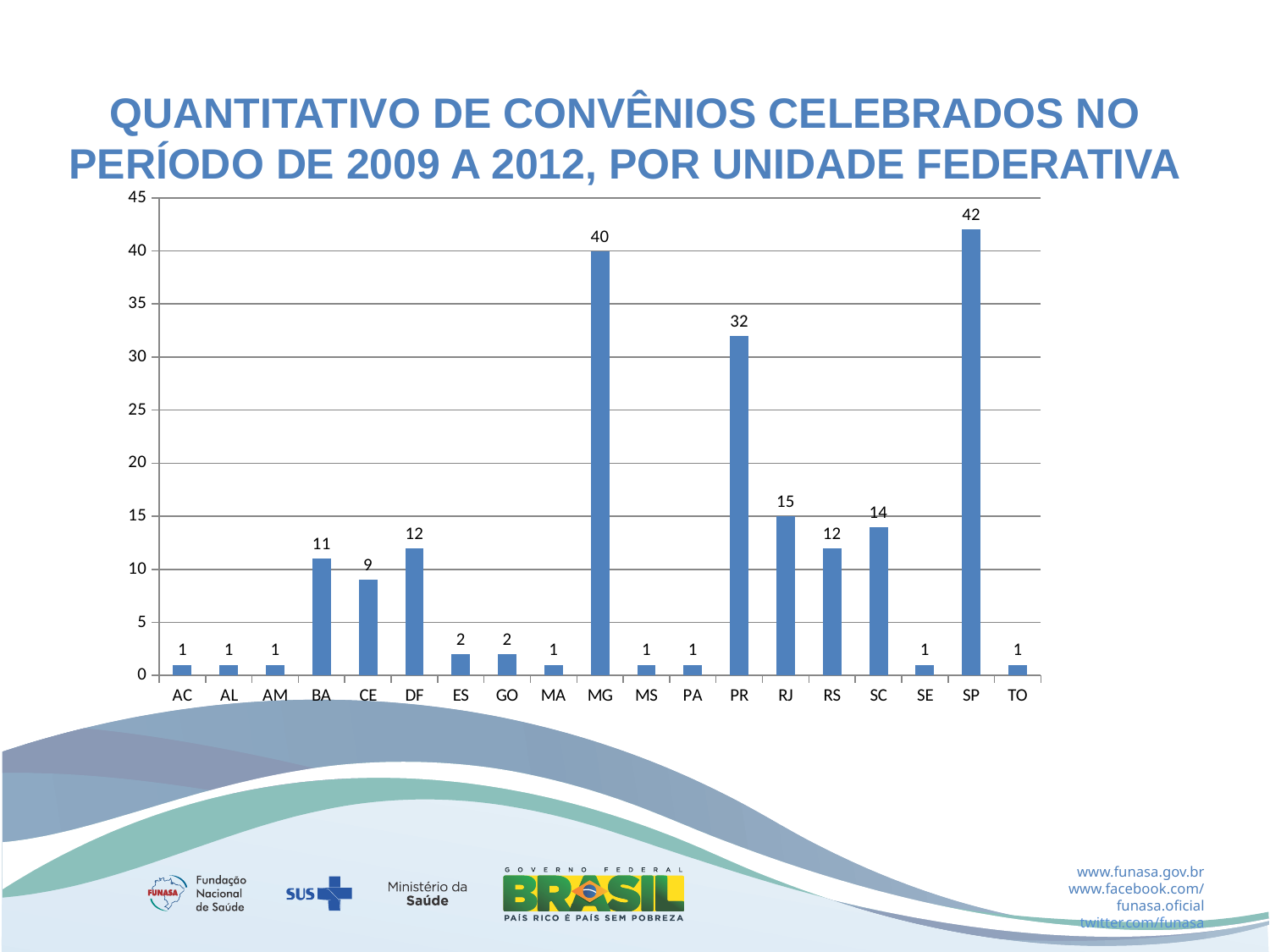
What is the value for CE? 9 What is the difference between the values for SP and MG? 2 Which is larger, the value for BA or the value for DF? DF What is the value for MG? 40 What is the value for SC? 14 What is the difference between the values for RJ and RS? 3 What kind of chart is shown on the slide? Bar chart Which unit has the highest value? SP What is the title of the chart? QUANTITATIVO DE CONVÊNIOS CELEBRADOS NO PERÍODO DE 2009 A 2012, POR UNIDADE FEDERATIVA What is the value for PR? 32 How many federative units are shown on the x axis? 19 Which is larger, the value for PR or the value for RJ? PR